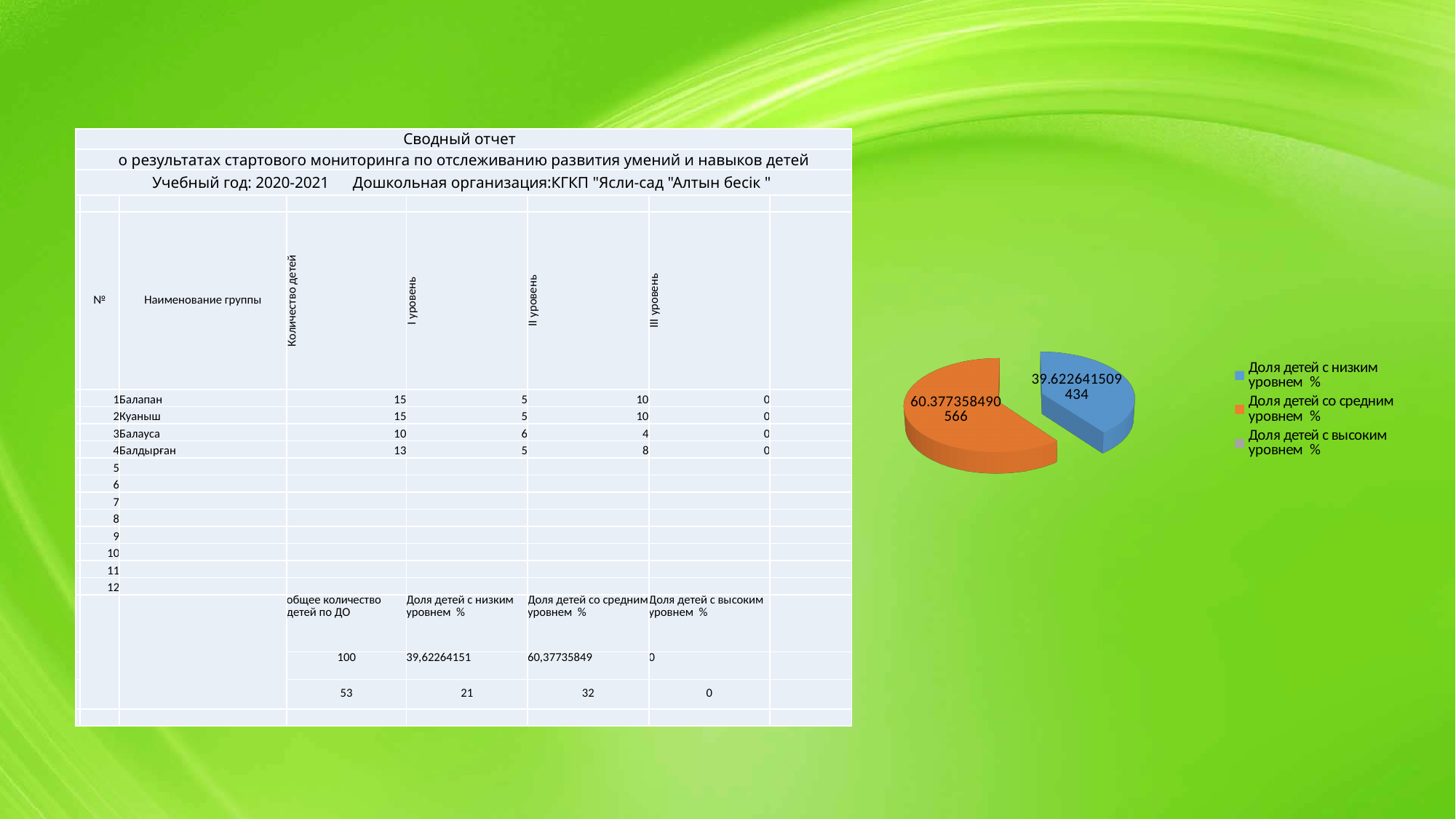
Which legend entry corresponds to the blue slice of the pie chart? Доля детей с низким уровнем % What value is labelled on the orange slice of the pie chart? 60.377358490566 What colour is the slice for 'Доля детей со средним уровнем %' in the pie chart? orange Is the slice for 'Доля детей с низким уровнем %' larger or smaller than the slice for 'Доля детей со средним уровнем %'? smaller How many slices are visibly drawn in the pie chart? 2 What value is labelled on the blue slice of the pie chart? 39.622641509434 What kind of chart is shown on the right side of the slide? pie chart How many entries does the legend of the pie chart list? 3 Which legend entry corresponds to the largest slice of the pie chart? Доля детей со средним уровнем % What is the difference between the orange slice value and the blue slice value in the pie chart? 20.754716981132